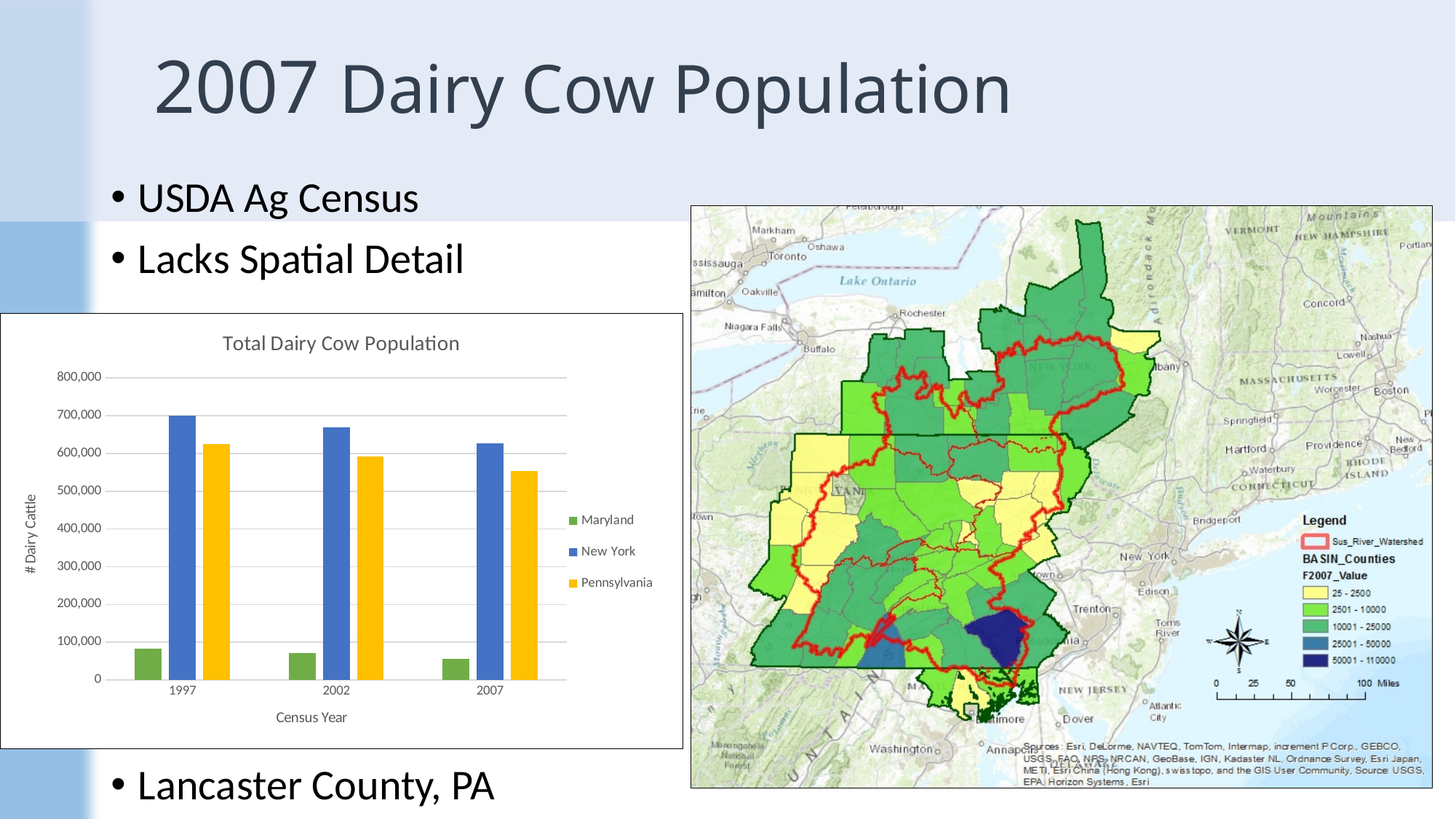
What kind of chart is the "Total Dairy Cow Population" chart? bar chart How many series does the legend of the "Total Dairy Cow Population" chart list? 3 In the "Total Dairy Cow Population" chart, which state has the lowest value in 1997? Maryland In the "Total Dairy Cow Population" chart, which is larger in 2002: New York or Pennsylvania? New York In the "Total Dairy Cow Population" chart, is the value for Pennsylvania in 2007 greater or less than 500,000? greater How many census years are shown on the x axis of the "Total Dairy Cow Population" chart? 3 In the "Total Dairy Cow Population" chart, is the value for New York in 2002 greater or less than 600,000? greater In the "Total Dairy Cow Population" chart, do the Maryland values rise or fall across the census years? fall In the "Total Dairy Cow Population" chart, which state has the highest value in 2007? New York In the "Total Dairy Cow Population" chart, is the value for Maryland in 1997 greater or less than 100,000? less What is the y-axis title of the "Total Dairy Cow Population" chart? # Dairy Cattle In the "Total Dairy Cow Population" chart, do the New York values rise or fall from 1997 to 2007? fall